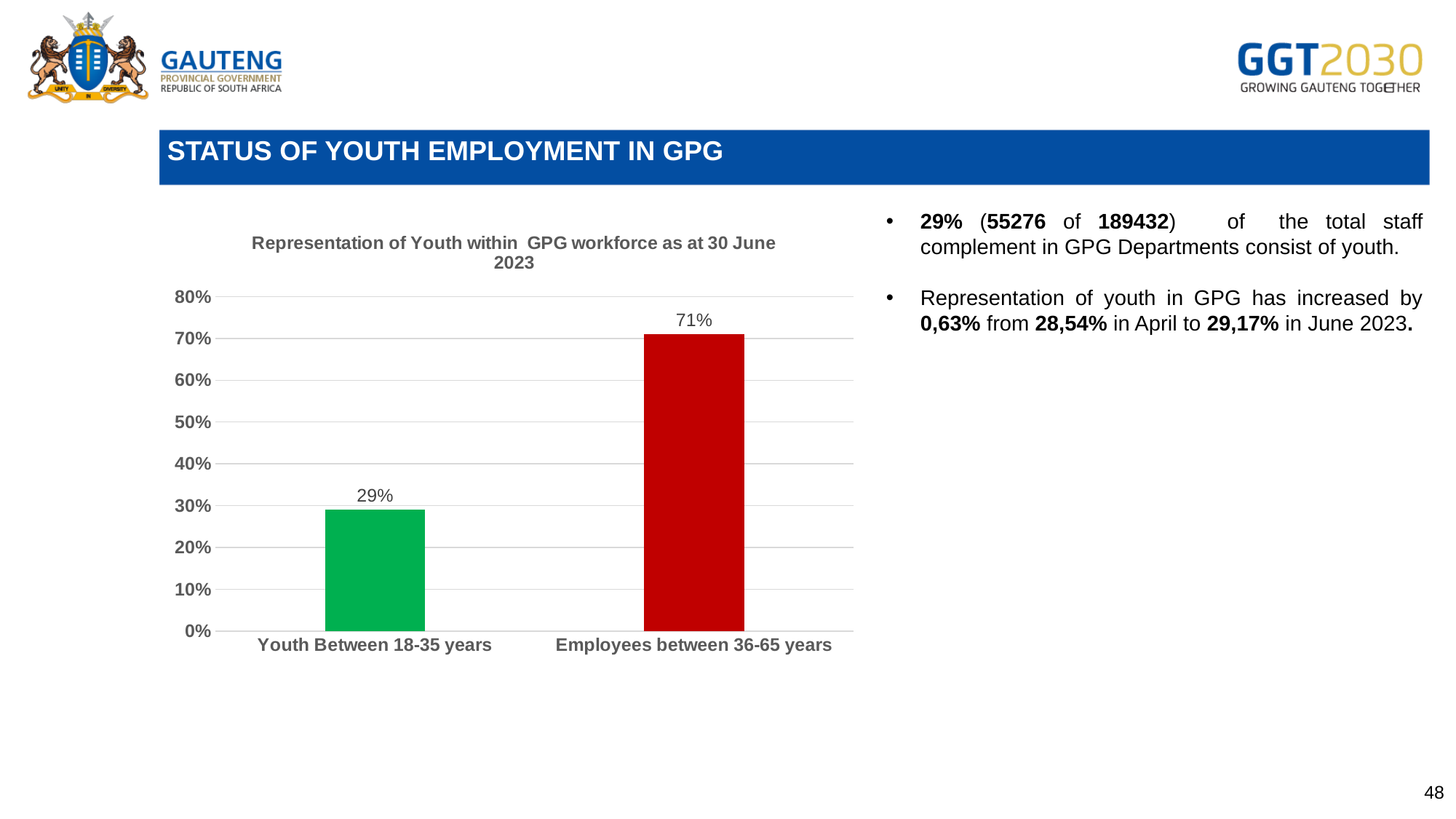
Which is larger, the value for Youth Between 18-35 years or the value for Employees between 36-65 years? Employees between 36-65 years Is the value for Youth Between 18-35 years greater or less than 40%? less What colour is the bar for Youth Between 18-35 years? green Which category has the highest value? Employees between 36-65 years What is the title of the chart? Representation of Youth within GPG workforce as at 30 June 2023 What is the difference between the values for Employees between 36-65 years and Youth Between 18-35 years? 42% Which category has the lowest value? Youth Between 18-35 years What is the value for Employees between 36-65 years? 71% How many categories are shown on the chart? 2 What kind of chart is shown on the slide? bar chart What is the value for Youth Between 18-35 years? 29% Is the value for Employees between 36-65 years greater or less than 60%? greater